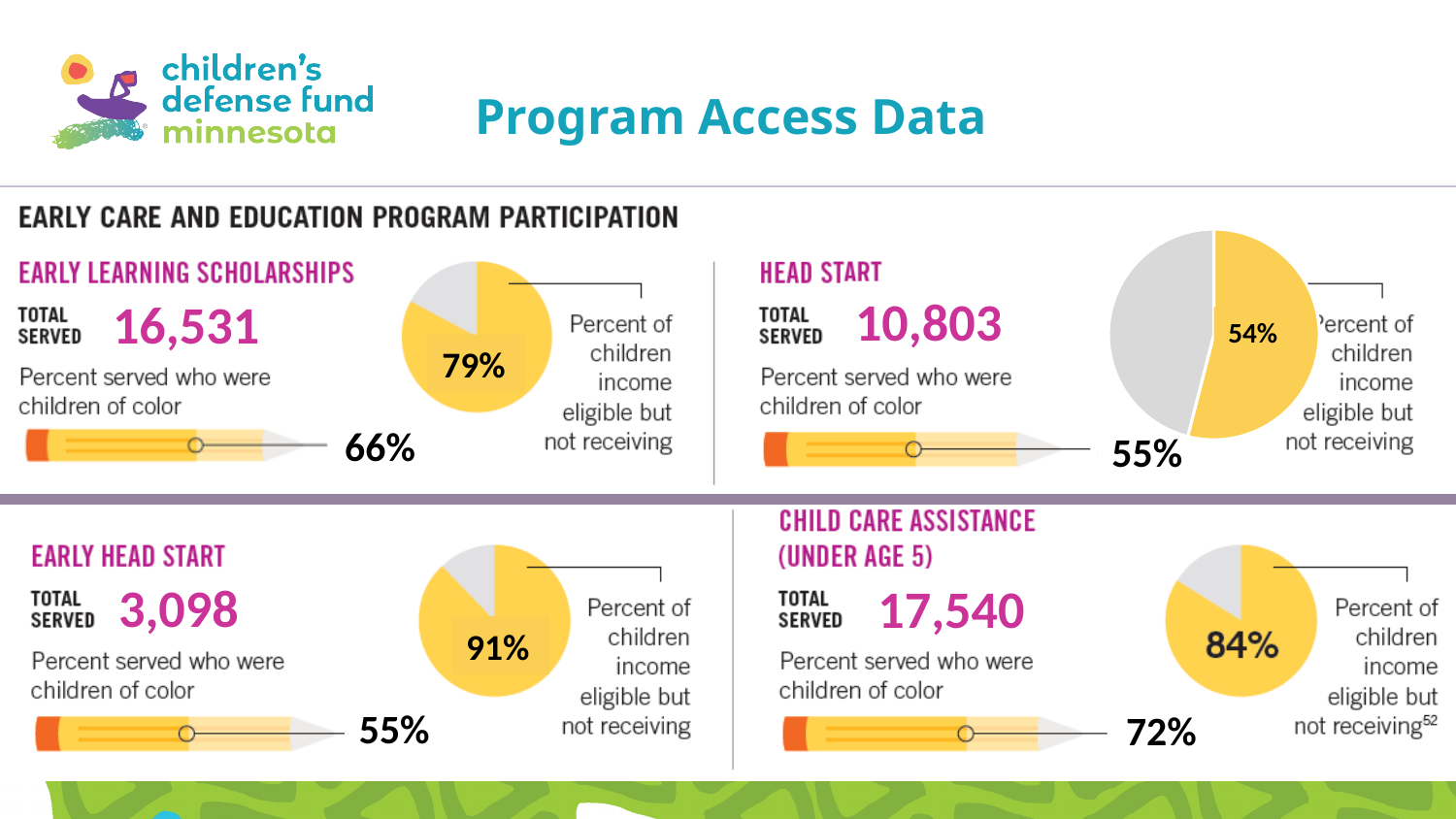
Which program's pie chart shows the lowest percent of children income eligible but not receiving? Head Start What colour is the slice representing children income eligible but not receiving in the pie charts? Yellow How many pie charts are shown on the slide? 4 In the Child Care Assistance (Under Age 5) pie chart, what percent of children were income eligible but not receiving? 84% What is the total served for the Head Start program? 10,803 In the Early Head Start pie chart, what percent of children were income eligible but not receiving? 91% In the Early Learning Scholarships pie chart, what percent of children were income eligible but not receiving? 79% What is the difference between the Early Head Start and Head Start pie chart percentages of children income eligible but not receiving? 37% Which program's pie chart shows the highest percent of children income eligible but not receiving? Early Head Start Which is larger: the Child Care Assistance pie chart percentage or the Early Learning Scholarships pie chart percentage? Child Care Assistance What kind of chart is used to show the percent of children income eligible but not receiving in each panel? Pie chart